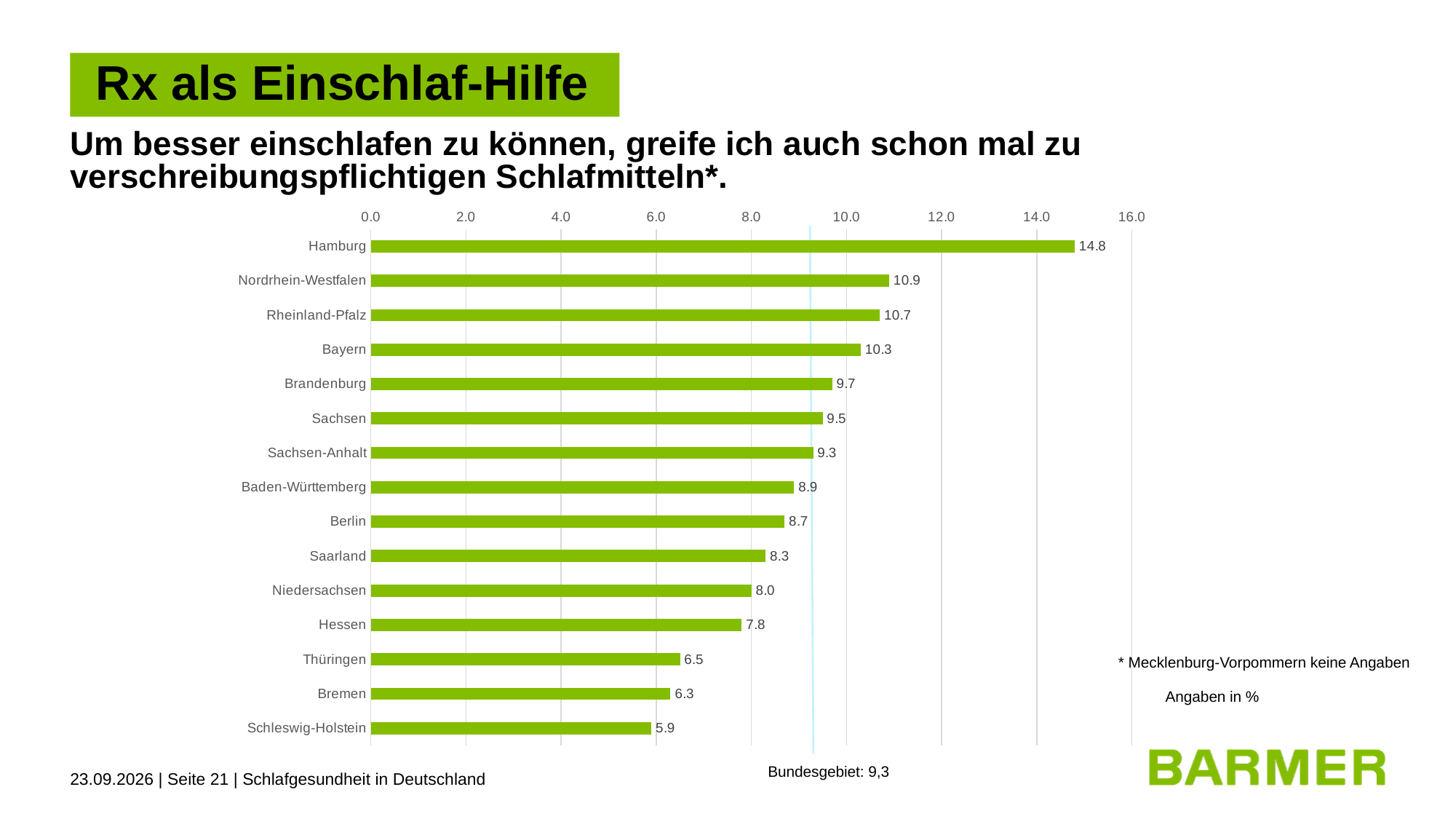
What is the value for Hamburg? 14.8 Which has a larger value, Saarland or Hessen? Saarland Which federal state is noted as having no data (keine Angaben)? Mecklenburg-Vorpommern How many federal states are shown in the chart? 15 What is the value for Bayern? 10.3 What kind of chart is shown on the slide? bar chart What is the value for Schleswig-Holstein? 5.9 Which federal state has the highest value? Hamburg What is the value given for Bundesgebiet below the chart? 9,3 Is the value for Brandenburg greater or less than 8.0? greater What is the difference between the values for Hamburg and Nordrhein-Westfalen? 3.9 Which federal state has the lowest value? Schleswig-Holstein